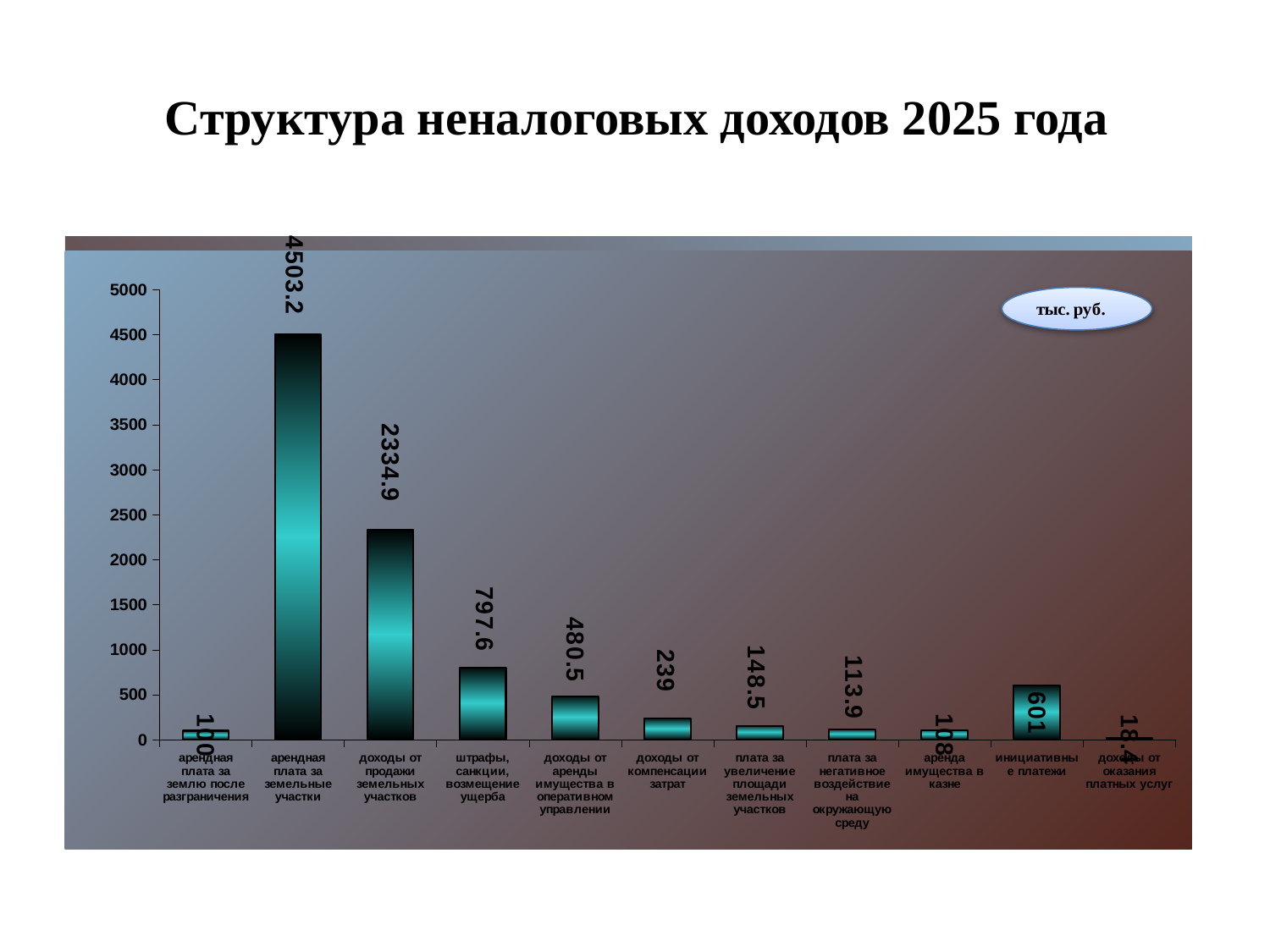
What is the title of the slide? Структура неналоговых доходов 2025 года What type of chart is shown on the slide? bar chart What is the value for 'арендная плата за земельные участки'? 4503.2 What is the value for 'доходы от продажи земельных участков'? 2334.9 How many categories are shown on the x axis? 11 What is the value for 'инициативные платежи'? 601 Which category has the highest value? арендная плата за земельные участки What is the difference between 'арендная плата за земельные участки' and 'доходы от продажи земельных участков'? 2168.3 What is the value for 'штрафы, санкции, возмещение ущерба'? 797.6 Which category has the lowest value? доходы от оказания платных услуг Which is larger: 'доходы от компенсации затрат' or 'плата за увеличение площади земельных участков'? доходы от компенсации затрат What unit is indicated in the label on the chart? тыс. руб.